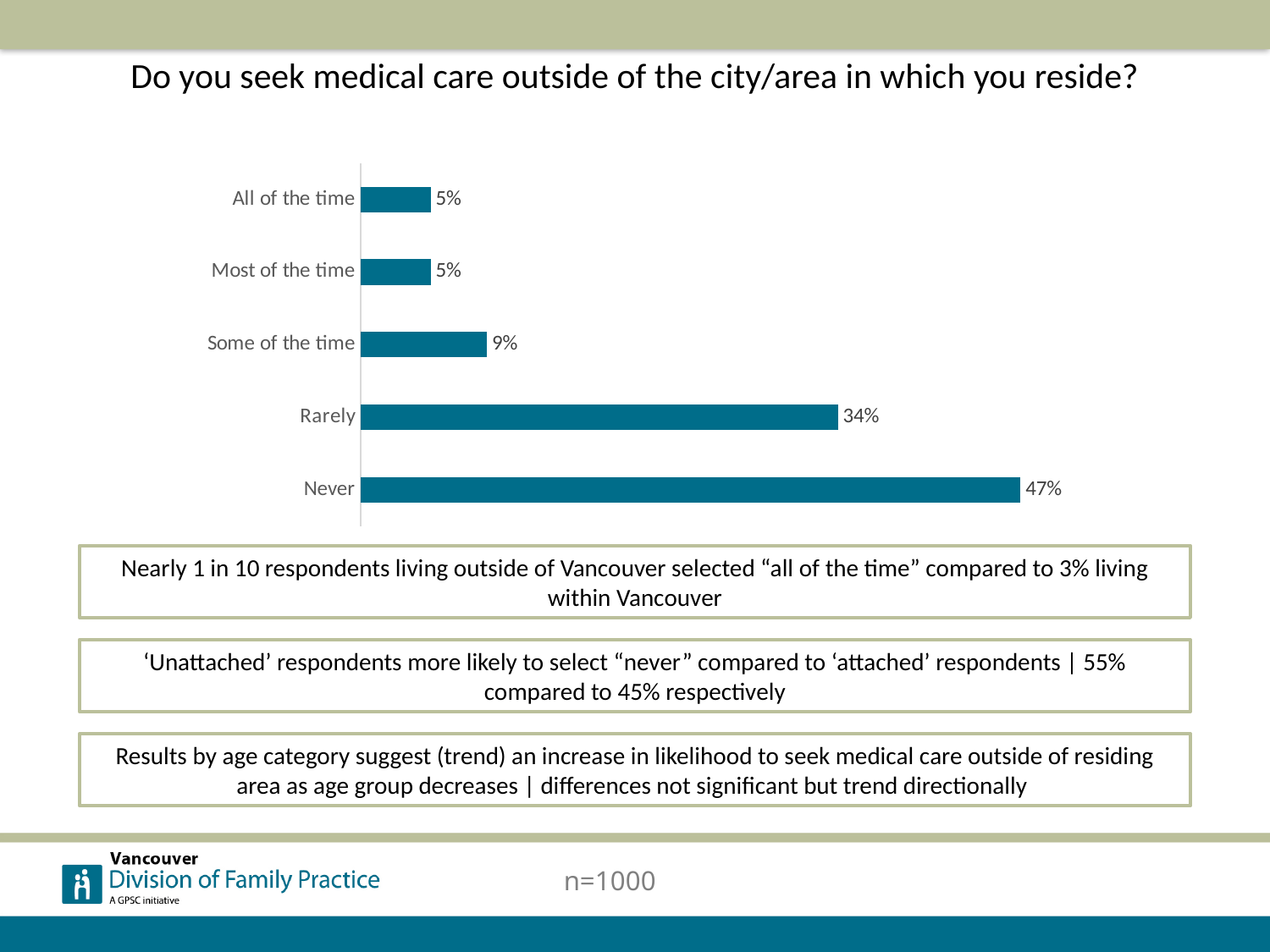
What is the difference in percentage points between "Never" and "Rarely"? 13 What type of chart is shown on the slide? Bar chart Which is larger, the value for "Rarely" or the value for "Some of the time"? Rarely What is the sample size (n) shown on the slide? n=1000 What percentage of respondents selected "Rarely"? 34% How many response categories are shown in the chart? 5 What is the difference in percentage points between "Some of the time" and "Most of the time"? 4 What is the combined percentage for "All of the time" and "Most of the time"? 10% Which response category has the highest percentage? Never What percentage of respondents selected "All of the time"? 5% What percentage of respondents selected "Some of the time"? 9% What percentage of respondents selected "Never"? 47%